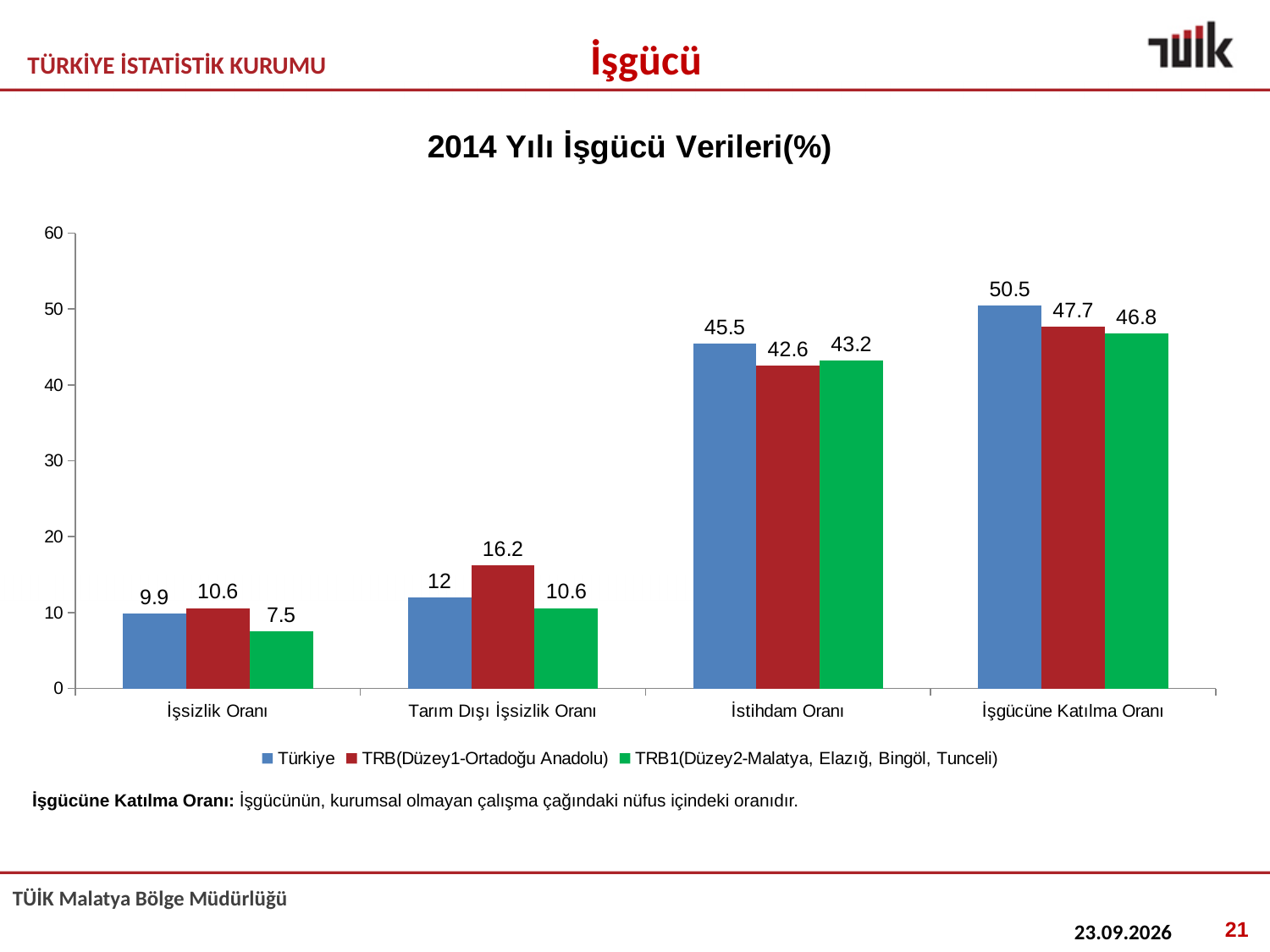
What kind of chart is shown on the slide? bar chart What is the value for Türkiye in the İşsizlik Oranı category? 9.9 How many categories are shown on the x axis? 4 What is the value for TRB1(Düzey2-Malatya, Elazığ, Bingöl, Tunceli) in the İstihdam Oranı category? 43.2 What is the title of the chart? 2014 Yılı İşgücü Verileri(%) Is the value for TRB(Düzey1-Ortadoğu Anadolu) in the İşgücüne Katılma Oranı category greater or less than 50? less How many series does the legend list? 3 Which series has the lowest value in the İşsizlik Oranı category? TRB1(Düzey2-Malatya, Elazığ, Bingöl, Tunceli) In the Tarım Dışı İşsizlik Oranı category, which is larger: the Türkiye value or the TRB1(Düzey2-Malatya, Elazığ, Bingöl, Tunceli) value? Türkiye Which series has the highest value in the İşgücüne Katılma Oranı category? Türkiye What is the value for TRB(Düzey1-Ortadoğu Anadolu) in the Tarım Dışı İşsizlik Oranı category? 16.2 What is the difference between the Türkiye and TRB(Düzey1-Ortadoğu Anadolu) values in the İstihdam Oranı category? 2.9